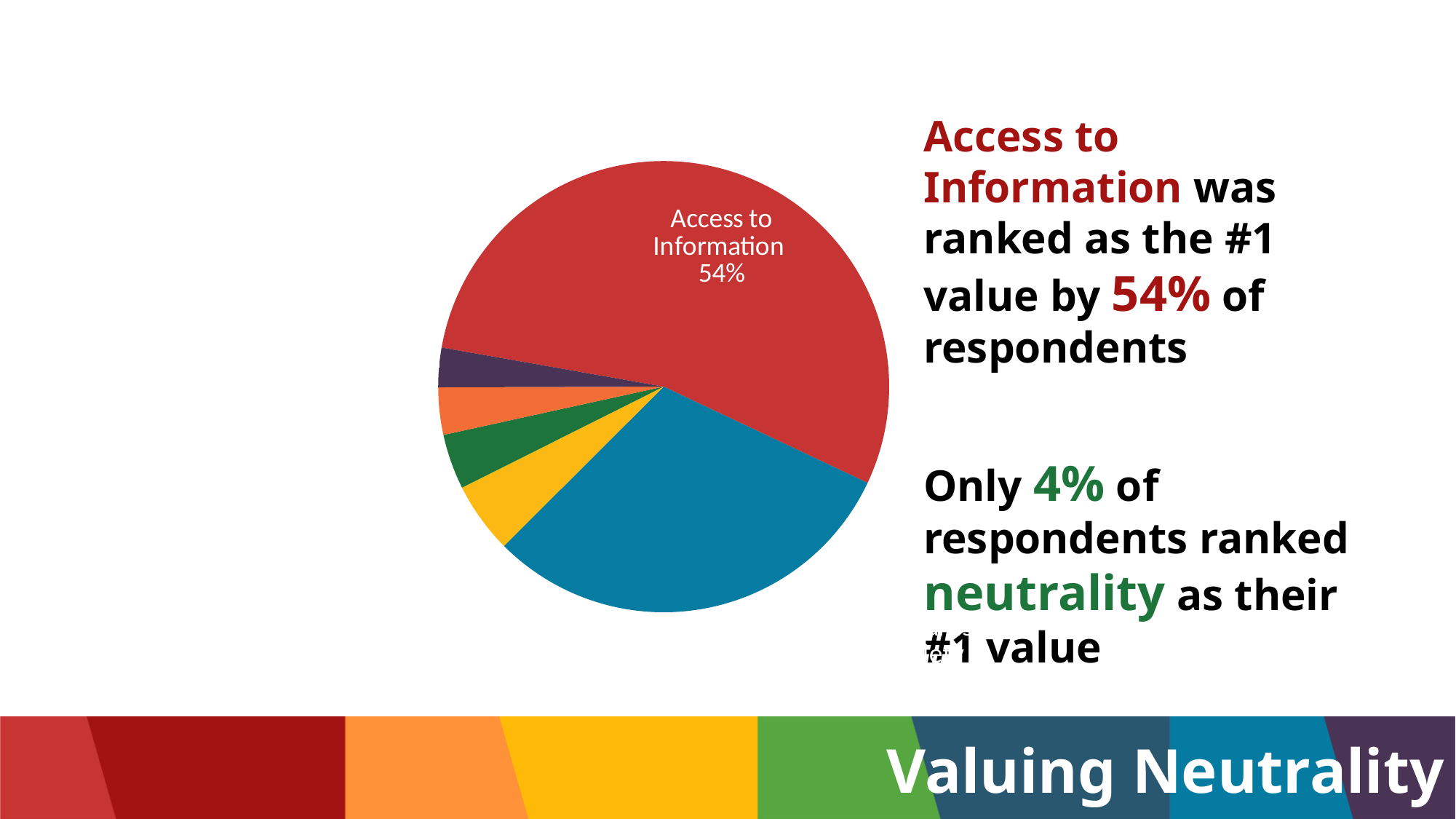
Which is larger: the Access to Information slice or the blue slice? Access to Information Which slice of the pie chart is the largest? Access to Information How many slices does the pie chart have? 6 Does the Access to Information slice make up more than half of the pie? Yes What colour is the Access to Information slice in the pie chart? red Which slice of the pie chart has a data label? Access to Information What share of the pie does Access to Information represent? 54% What type of chart is shown on the slide? pie chart Is the value for Access to Information greater or less than 50%? greater What percentage of the pie is the Access to Information slice? 54%